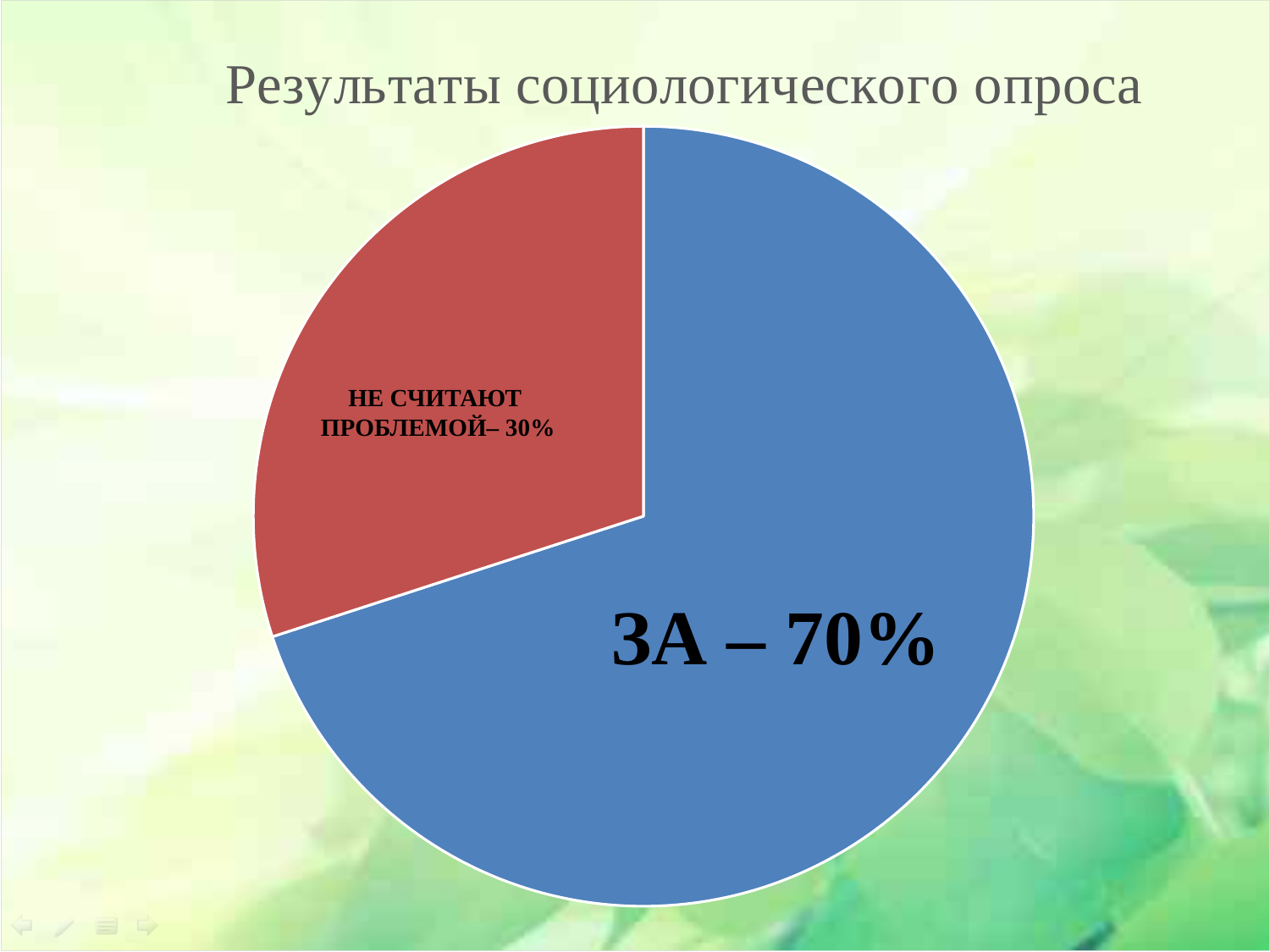
How many slices does the pie chart have? 2 What is the title of the chart? Результаты социологического опроса What kind of chart is shown on the slide? pie chart What is the difference in percentage points between the "ЗА" slice and the "НЕ СЧИТАЮТ ПРОБЛЕМОЙ" slice? 40 percentage points Which is larger, the "ЗА" slice or the "НЕ СЧИТАЮТ ПРОБЛЕМОЙ" slice? ЗА What share of the pie is labelled "НЕ СЧИТАЮТ ПРОБЛЕМОЙ"? 30% Which slice is the largest? ЗА What share of the pie is labelled "ЗА"? 70% Is the share for "НЕ СЧИТАЮТ ПРОБЛЕМОЙ" greater or less than 50%? less Which slice is the smallest? НЕ СЧИТАЮТ ПРОБЛЕМОЙ What colour is the "ЗА" slice? blue